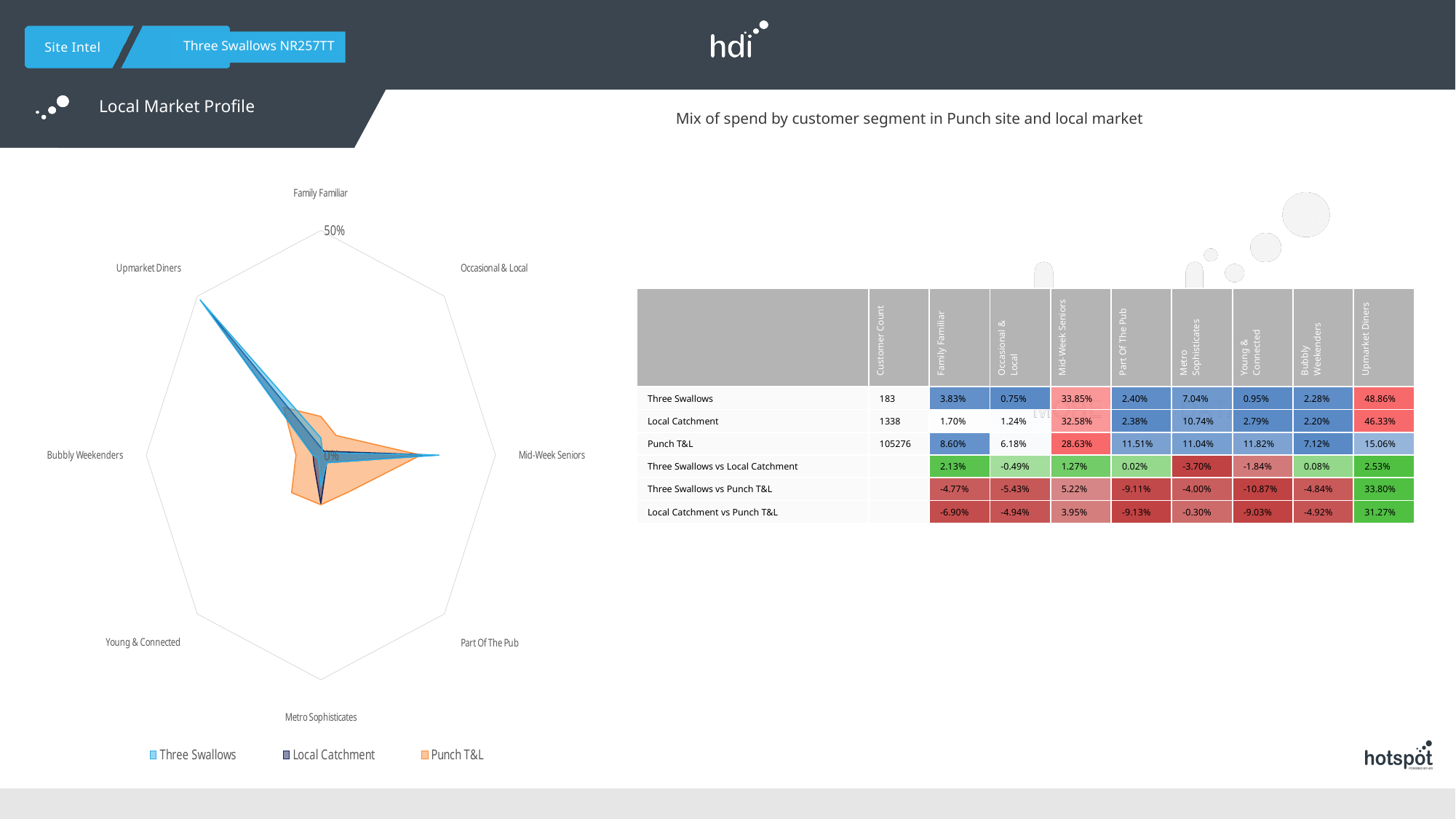
According to the table, what is the difference between Three Swallows and Local Catchment for Family Familiar? 2.13% What kind of chart is shown on the left of the slide? Radar chart On the radar chart, which segment has the highest value for Three Swallows? Upmarket Diners According to the table, what is the Three Swallows share for Mid-Week Seniors? 33.85% Is the Three Swallows value for Upmarket Diners greater or less than 50%? less Which series is shown in orange on the radar chart? Punch T&L What is the maximum value shown on the radar chart's axis scale? 50% Which is larger for Upmarket Diners: Three Swallows or Local Catchment? Three Swallows According to the table, what is the Punch T&L share for Upmarket Diners? 15.06% How many customer segments (axes) does the radar chart have? 8 How many series does the radar chart's legend list? 3 On the radar chart, which segment has the highest value for Punch T&L? Mid-Week Seniors